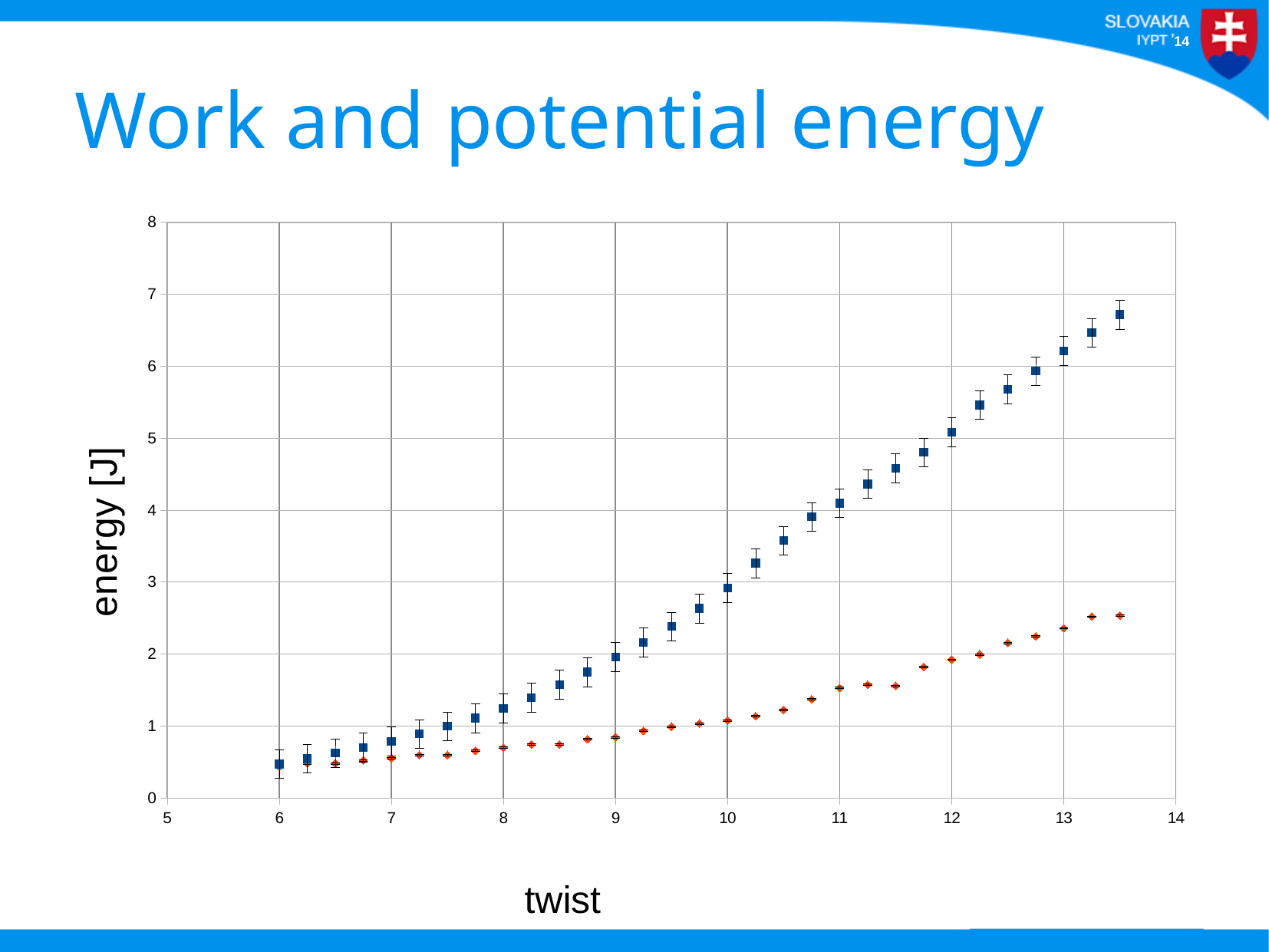
What is the label of the vertical axis? energy [J] What kind of chart is shown on the slide? scatter chart Is the value of the blue square series at twist 10 greater or less than 4? less Is the value of the blue square series at twist 6 greater or less than 1? less Is the value of the blue square series at twist 13.5 greater or less than 6? greater Do the values of the red diamond series rise or fall as twist increases? rise At twist 12, which series has the larger energy value, the blue squares or the red diamonds? blue squares Do the values of the blue square series rise or fall as twist increases? rise What is the title of the chart on the slide? Work and potential energy At twist 9, which series has the larger energy value, the blue squares or the red diamonds? blue squares